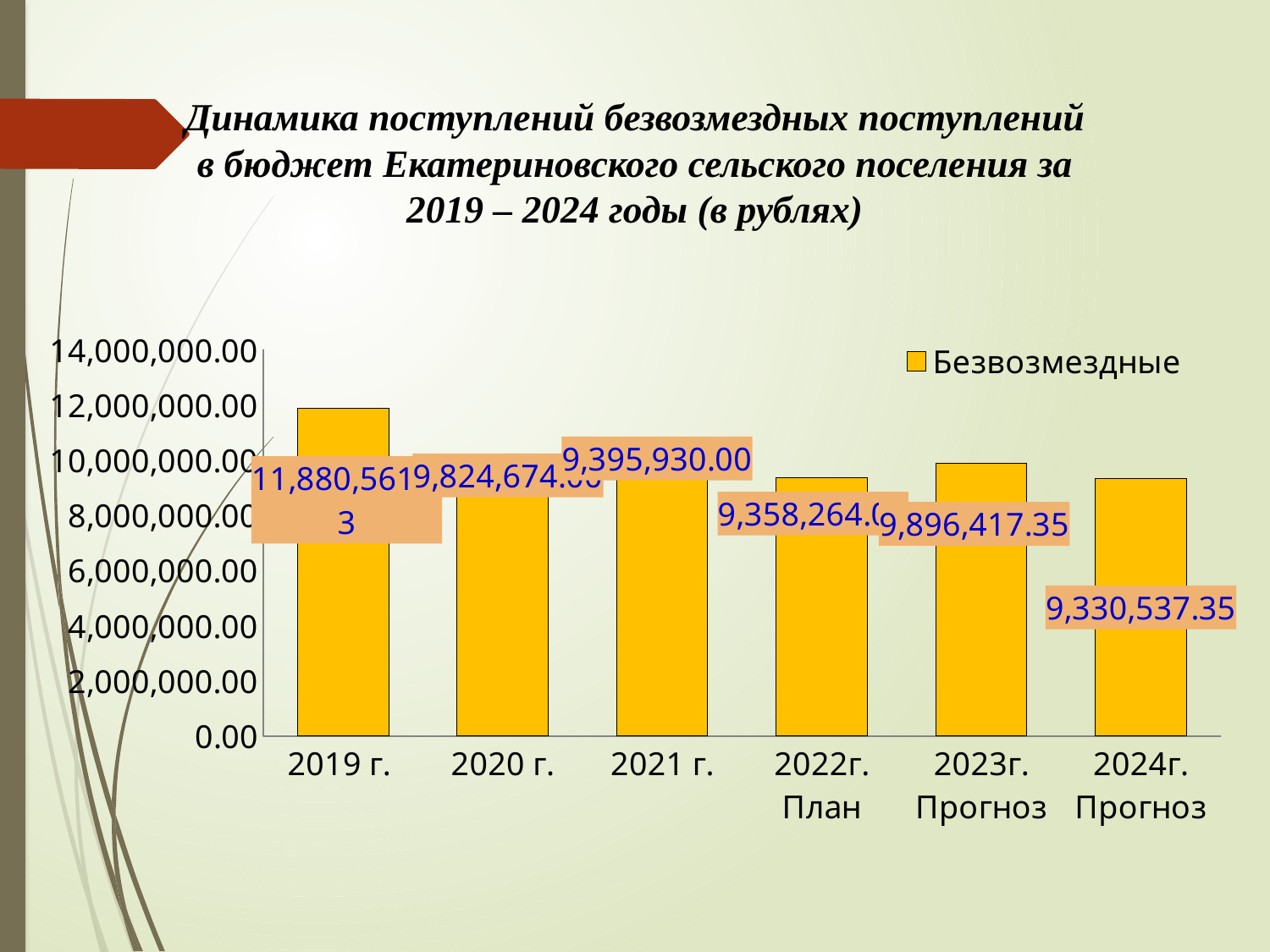
What is the value for 2024г. Прогноз? 9,330,537.35 Which is larger, the value for 2019 г. or the value for 2020 г.? 2019 г. Is the value for 2024г. Прогноз greater or less than 10,000,000.00? less Is the value for 2019 г. greater or less than 10,000,000.00? greater Which year has the highest value? 2019 г. What is the difference between the values for 2023г. Прогноз and 2024г. Прогноз? 565,880.00 How many series does the legend list? 1 What is the value for 2023г. Прогноз? 9,896,417.35 What is the difference between the values for 2023г. Прогноз and 2021 г.? 500,487.35 What kind of chart is shown on the slide? bar chart What is the value for 2021 г.? 9,395,930.00 How many years (categories) are shown on the x axis? 6